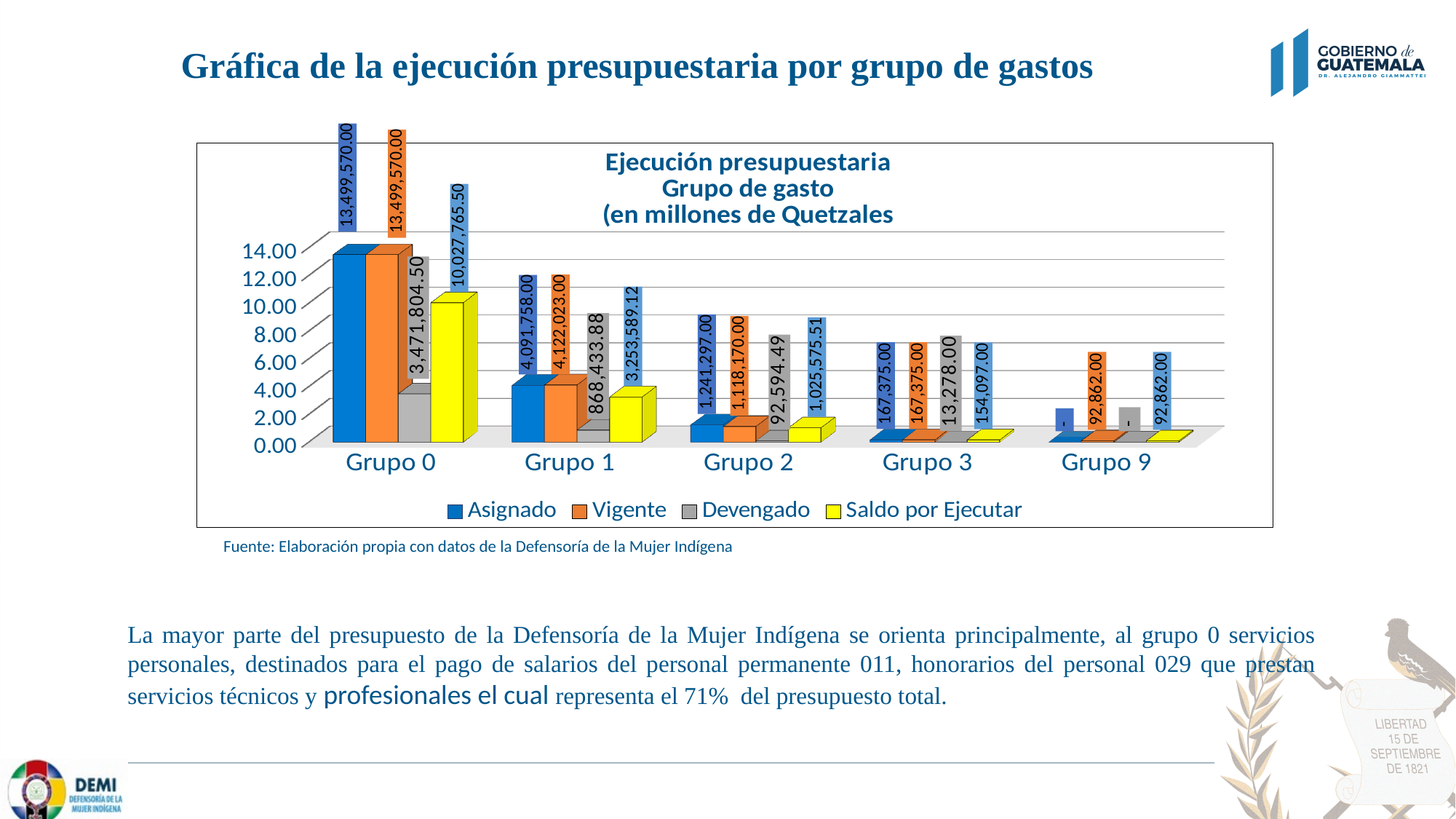
How many series does the legend list? 4 What is the difference between the Asignado and Vigente values for Grupo 2? 123,127.00 Which group has the lowest Devengado value among those with a printed numeric value? Grupo 3 How many groups (categories) are shown on the x axis? 5 Which is larger for Grupo 0: Devengado or Saldo por Ejecutar? Saldo por Ejecutar What is the Saldo por Ejecutar value for Grupo 2? 1,025,575.51 What is the Asignado value for Grupo 3? 167,375.00 Does the Vigente value rise or fall from Grupo 0 to Grupo 9? Fall What is the difference between the Vigente and Asignado values for Grupo 1? 30,265.00 What is the Devengado value for Grupo 1? 868,433.88 Which group has the highest Vigente value? Grupo 0 What is the Vigente value for Grupo 0? 13,499,570.00